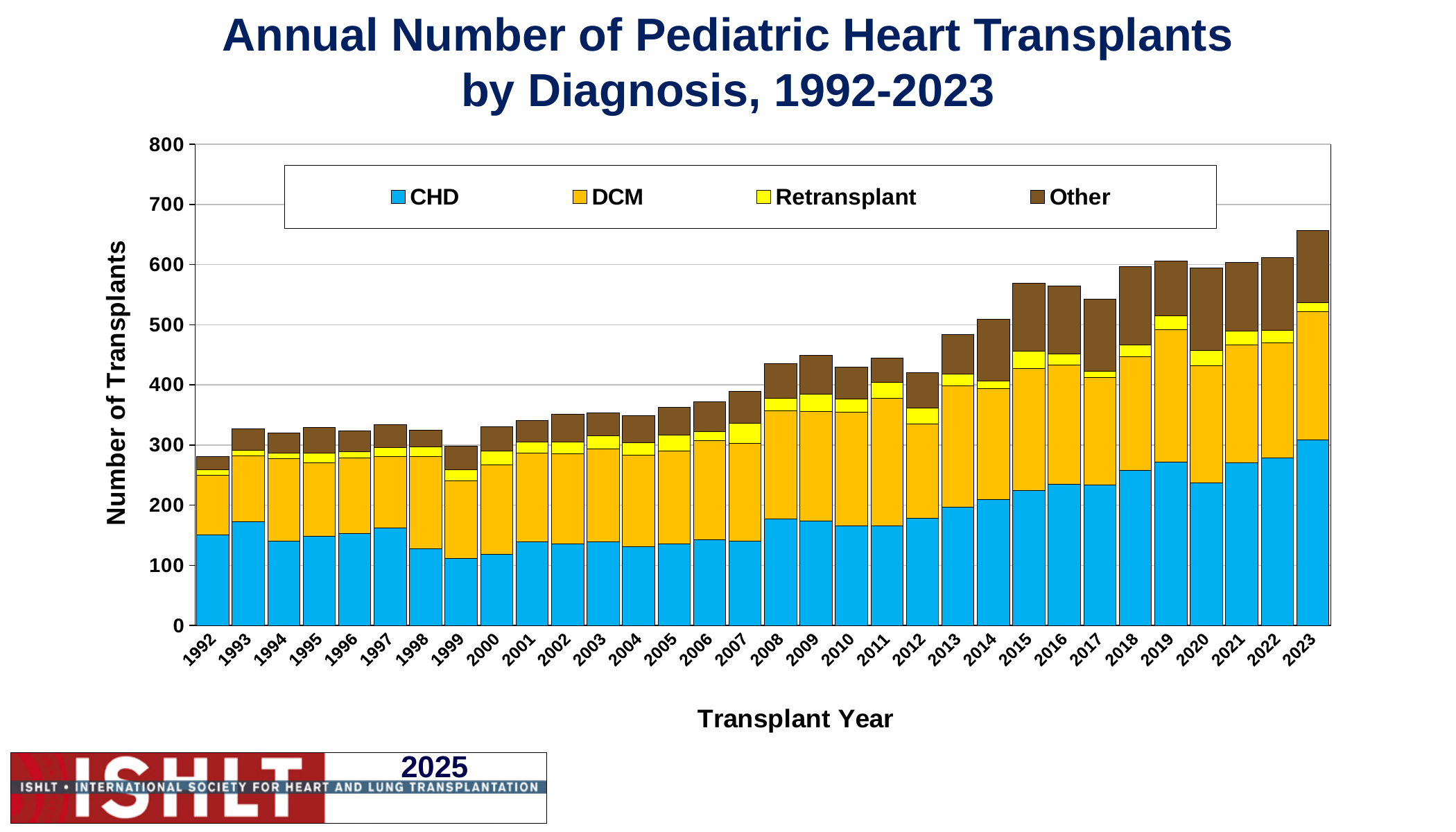
Is the total number of transplants in 2015 greater or less than 500? greater Is the total number of transplants in 2023 greater or less than 600? greater Which year has a larger total number of transplants, 2017 or 2019? 2019 Which transplant year has the lowest total number of transplants? 1992 Is the total number of transplants in 1992 greater or less than 300? less Which series is shown in brown at the top of each stacked bar? Other How many transplant years are shown on the x axis? 32 Which transplant year has the highest total number of transplants? 2023 Overall, do the total annual transplant numbers rise or fall from 1992 to 2023? Rise What kind of chart is shown on the slide? Stacked bar chart How many series does the legend list? 4